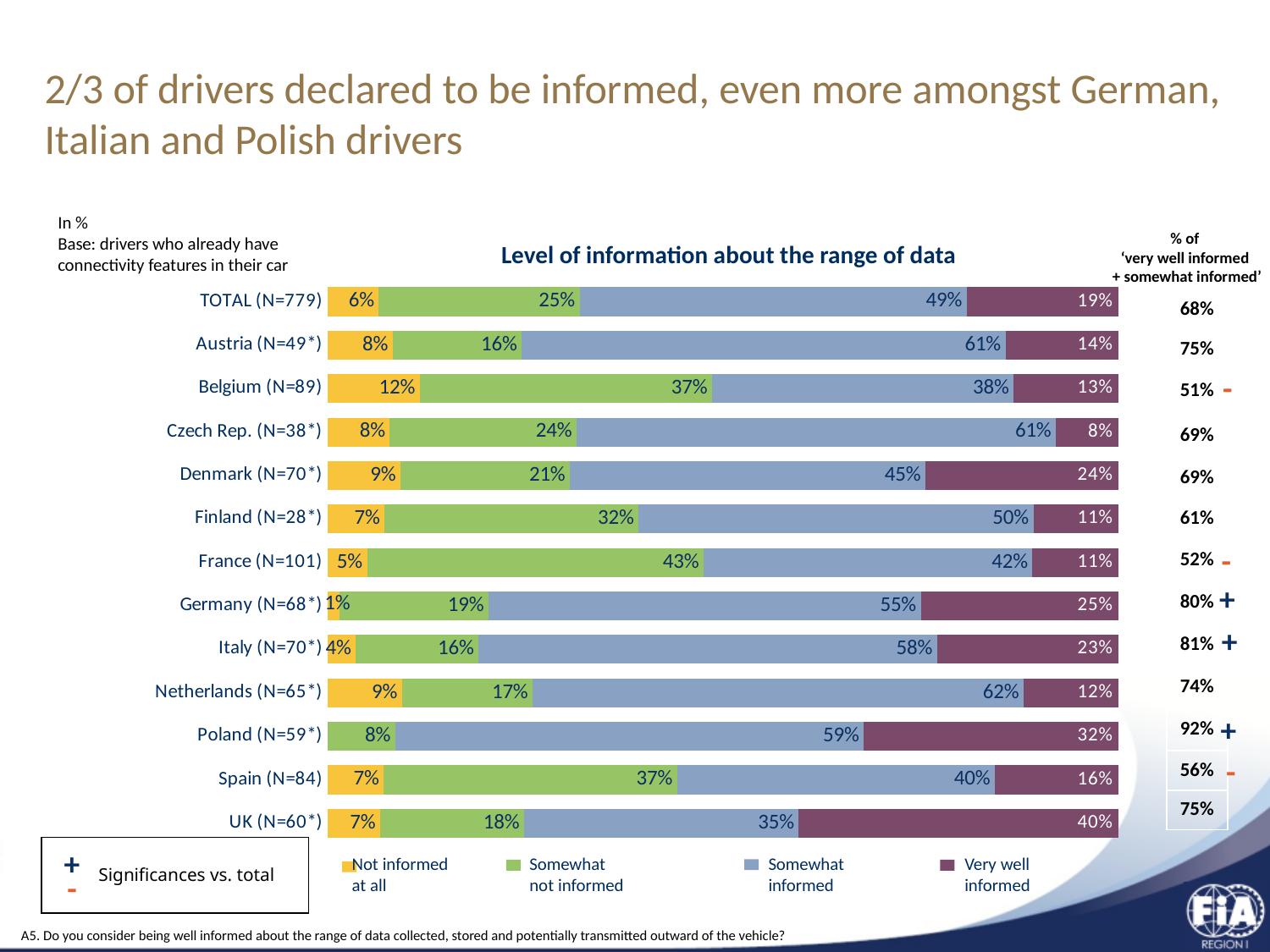
What is the '% of very well informed + somewhat informed' shown for Poland (N=59*)? 92% What is the title of the chart? Level of information about the range of data Which has the larger 'Somewhat not informed' value, France (N=101) or Belgium (N=89)? France (N=101) How many series does the legend list? 4 What kind of chart is shown on the slide? bar chart How many country/total categories are plotted in the chart? 13 What is the 'Not informed at all' value for Belgium (N=89)? 12% What is the difference between the 'Somewhat informed' values for Austria (N=49*) and Belgium (N=89)? 23 percentage points What is the 'Somewhat informed' value for Netherlands (N=65*)? 62% What is the 'Very well informed' value for UK (N=60*)? 40% Which category has the highest 'Very well informed' value? UK (N=60*)